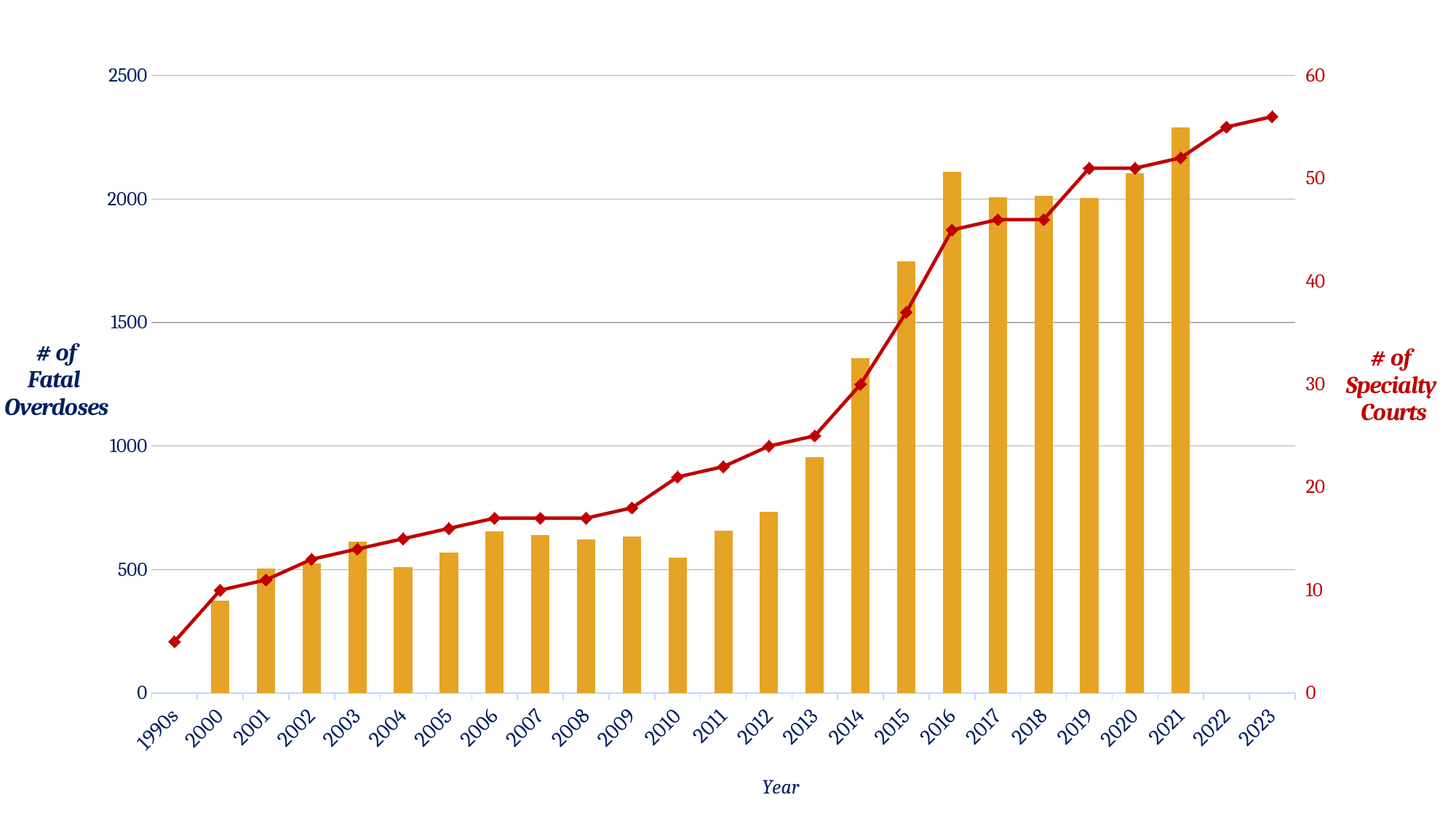
What kind of chart is shown on the slide? A combined bar and line chart Is the # of Specialty Courts value for the 1990s greater or less than 10? less What is the label of the right-hand vertical axis? # of Specialty Courts Which year has a taller # of Fatal Overdoses bar, 2015 or 2016? 2016 Is the # of Fatal Overdoses bar for 2021 greater or less than 2000? greater Does the # of Specialty Courts line generally rise or fall from the 1990s to 2023? Rise Is the # of Specialty Courts value for 2023 greater or less than 50? greater Which year has a taller # of Fatal Overdoses bar, 2009 or 2010? 2009 Which year has the tallest bar for # of Fatal Overdoses? 2021 How many categories are shown on the x axis? 25 Which year has the shortest bar for # of Fatal Overdoses? 2000